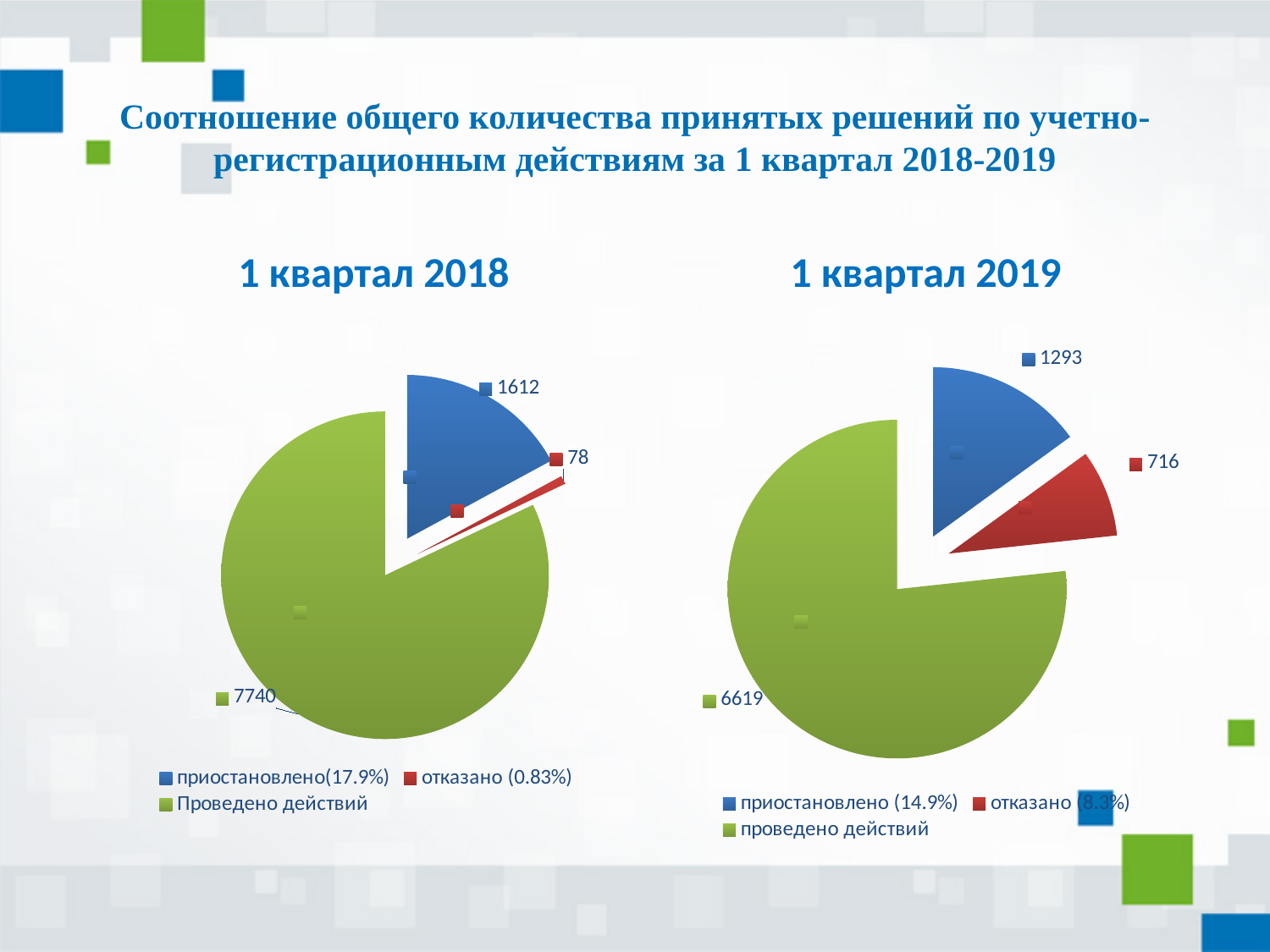
In the '1 квартал 2019' pie chart, what is the value for 'отказано'? 716 What is the total of all slices in the '1 квартал 2018' pie chart? 9430 According to the legend of the '1 квартал 2018' chart, what share of the pie is 'приостановлено'? 17.9% In the '1 квартал 2018' pie chart, which category has the largest slice? Проведено действий What is the difference between the 'приостановлено' value in the '1 квартал 2018' chart and the 'приостановлено' value in the '1 квартал 2019' chart? 319 In the '1 квартал 2019' pie chart, what is the value for 'проведено действий'? 6619 How many slices does the '1 квартал 2019' pie chart have? 3 In the '1 квартал 2019' pie chart, which category has the smallest slice? отказано Which is larger: the 'отказано' value in the '1 квартал 2018' chart or the 'отказано' value in the '1 квартал 2019' chart? 1 квартал 2019 In the '1 квартал 2018' pie chart, which category has the smallest slice? отказано What type of chart is used for '1 квартал 2018'? Pie chart In the '1 квартал 2018' pie chart, what is the value for 'приостановлено'? 1612